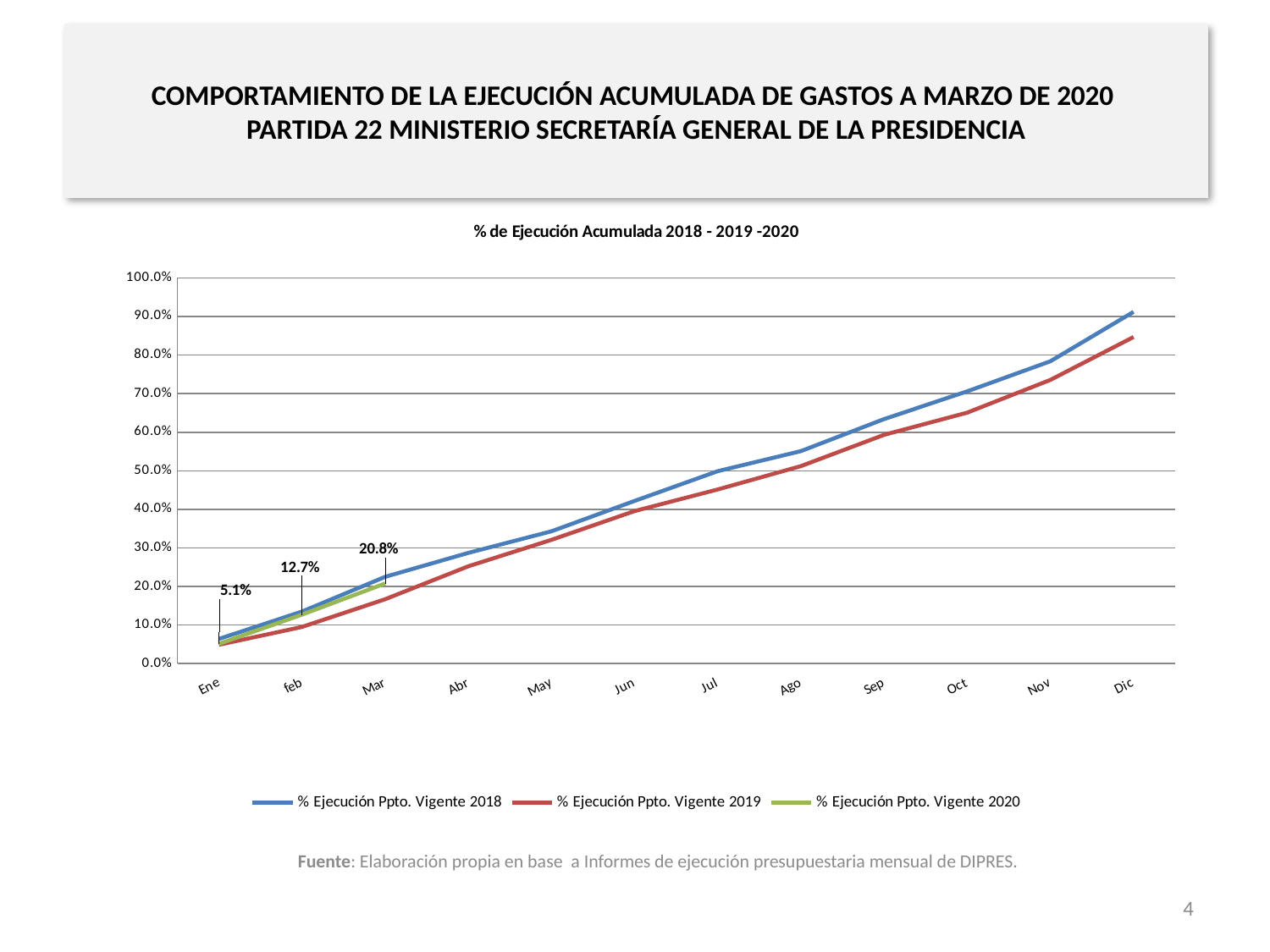
Do the values of % Ejecución Ppto. Vigente 2018 rise or fall from Ene to Dic? Rise What is the title of the chart? % de Ejecución Acumulada 2018 - 2019 -2020 Is the value for % Ejecución Ppto. Vigente 2019 in Nov greater or less than 70%? greater What is the value of % Ejecución Ppto. Vigente 2020 in Ene? 5.1% By how many percentage points did % Ejecución Ppto. Vigente 2020 increase from feb to Mar? 8.1 What is the value of % Ejecución Ppto. Vigente 2020 in Mar? 20.8% What type of chart is shown on the slide? Line chart Is the value for % Ejecución Ppto. Vigente 2019 in Dic greater or less than 80%? greater How many series does the legend list? 3 Which series has the higher value in Dic, % Ejecución Ppto. Vigente 2018 or % Ejecución Ppto. Vigente 2019? % Ejecución Ppto. Vigente 2018 What is the value of % Ejecución Ppto. Vigente 2020 in feb? 12.7% How many months are shown along the x axis? 12